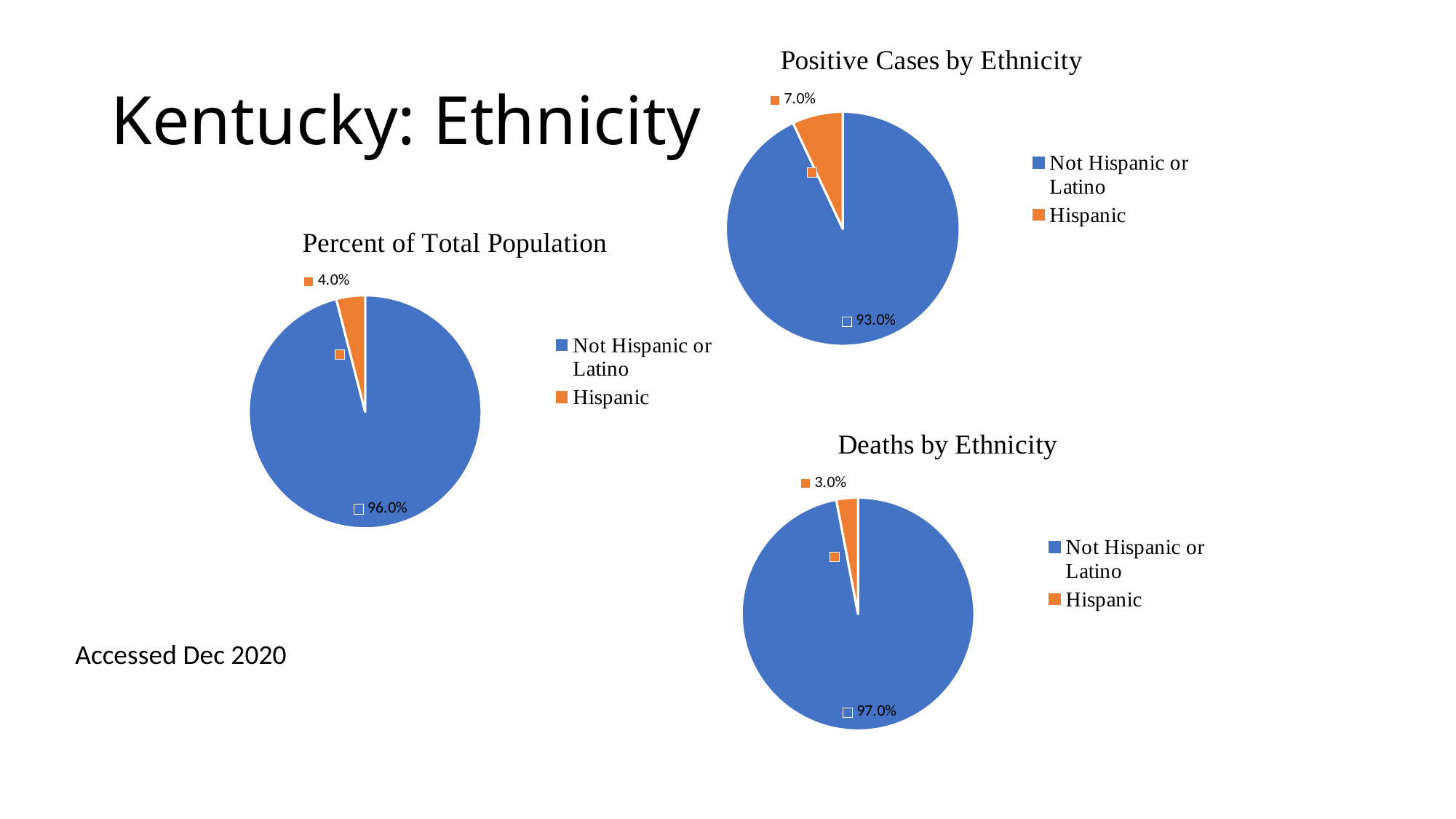
In the 'Percent of Total Population' chart, what share is Hispanic? 4.0% In the 'Deaths by Ethnicity' chart, what share is Not Hispanic or Latino? 97.0% What type of chart is 'Deaths by Ethnicity'? Pie chart What is the difference between the Hispanic share in the 'Positive Cases by Ethnicity' chart and the Hispanic share in the 'Percent of Total Population' chart? 3.0% In the 'Percent of Total Population' chart, what share is Not Hispanic or Latino? 96.0% In the 'Positive Cases by Ethnicity' chart, what share is Not Hispanic or Latino? 93.0% How many categories does the legend of the 'Percent of Total Population' chart list? 2 In the 'Positive Cases by Ethnicity' chart, what share is Hispanic? 7.0% In the 'Deaths by Ethnicity' chart, which category has the smallest slice? Hispanic In the 'Positive Cases by Ethnicity' chart, which category has the largest slice? Not Hispanic or Latino In the 'Deaths by Ethnicity' chart, what share is Hispanic? 3.0% Is the Hispanic share larger in the 'Positive Cases by Ethnicity' chart or the 'Deaths by Ethnicity' chart? Positive Cases by Ethnicity